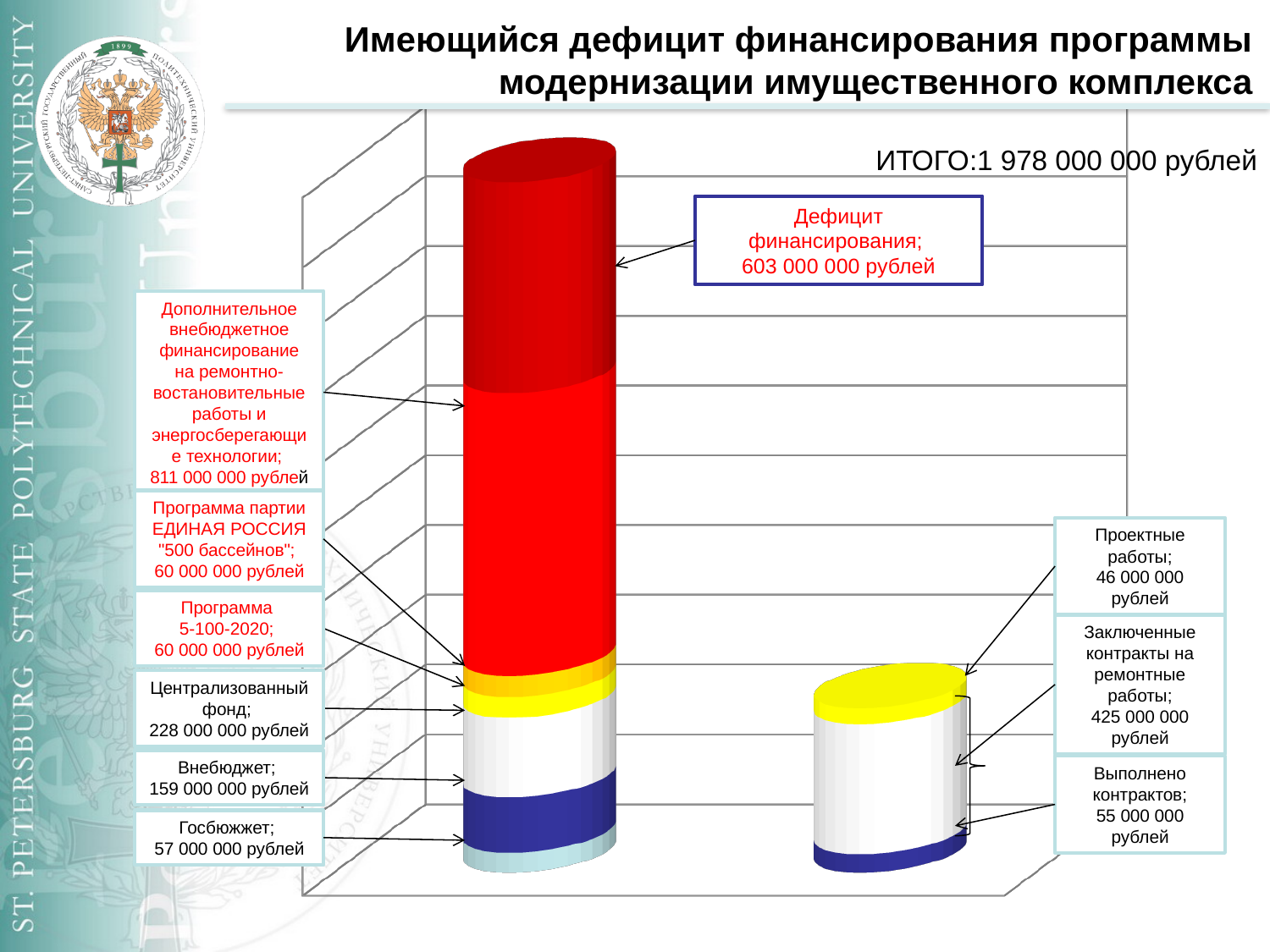
What is the total of the left stacked bar, as shown on the slide? 1 978 000 000 рублей What is the value of the 'Заключенные контракты на ремонтные работы' segment? 425 000 000 рублей What is the value of the 'Госбюджет' segment? 57 000 000 рублей What is the value of the 'Централизованный фонд' segment? 228 000 000 рублей What is the total of the right stacked bar (Проектные работы, Заключенные контракты на ремонтные работы, Выполнено контрактов)? 526 000 000 рублей How many segments make up the left stacked bar? 7 What kind of chart is shown on the slide? Stacked bar chart Which segment of the left bar has the largest value? Дополнительное внебюджетное финансирование на ремонтно-востановительные работы и энергосберегающие технологии What is the difference between the 'Дополнительное внебюджетное финансирование' segment and the 'Дефицит финансирования' segment? 208 000 000 рублей Which segment of the right bar has the smallest value? Проектные работы Which is larger: 'Внебюджет' or 'Централизованный фонд'? Централизованный фонд What is the value of the 'Дефицит финансирования' segment? 603 000 000 рублей